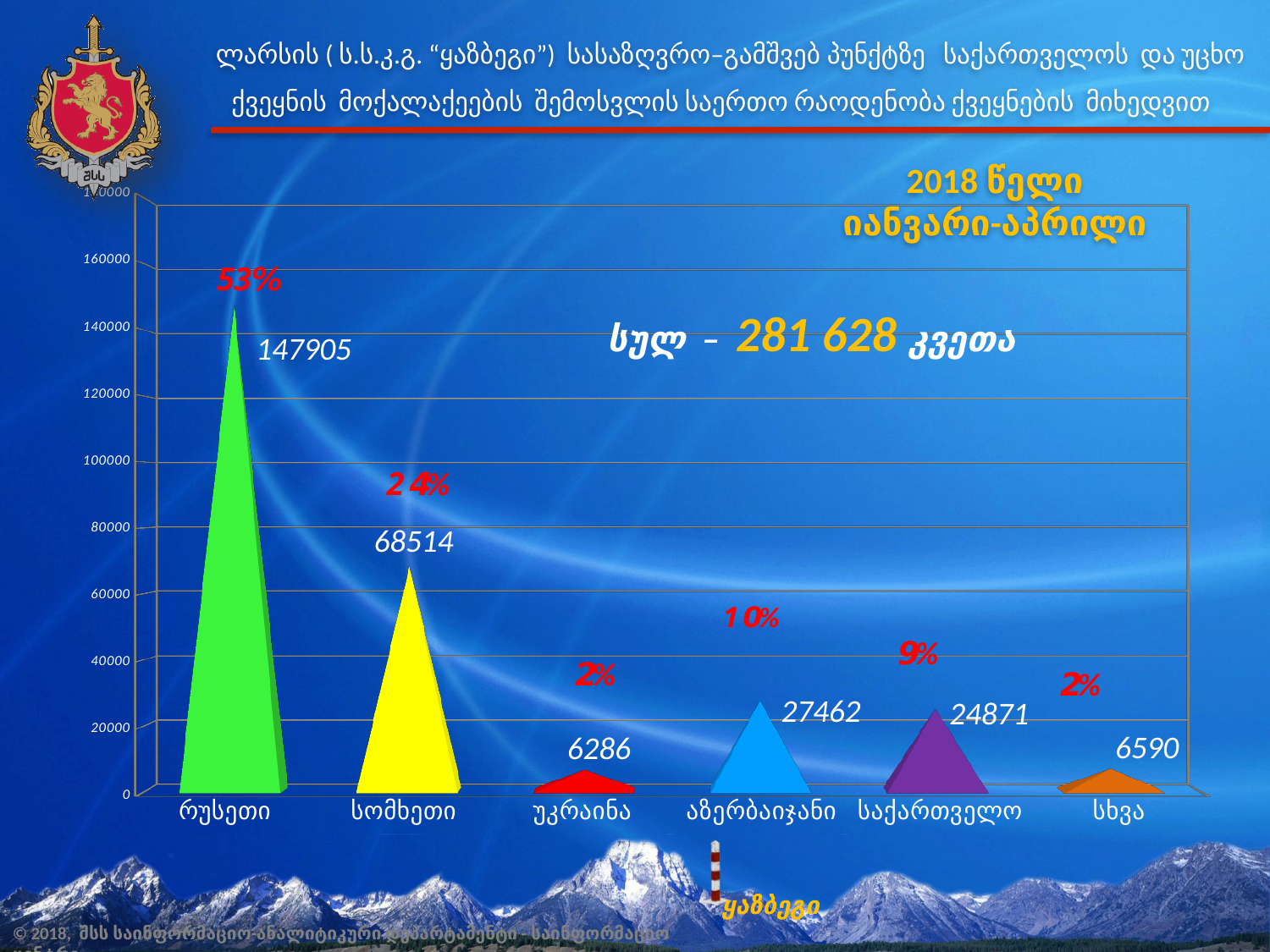
How many categories are shown on the x axis? 6 What is the value for სომხეთი? 68514 What is the value for რუსეთი? 147905 Which category has the highest value? რუსეთი What is the value for უკრაინა? 6286 What total is stated on the slide (სულ)? 281 628 Which is larger, the value for აზერბაიჯანი or the value for საქართველო? აზერბაიჯანი What is the value for აზერბაიჯანი? 27462 What percentage label is shown above the bar for სომხეთი? 24% What is the difference between the values for რუსეთი and სომხეთი? 79391 Which category has the lowest value? უკრაინა What is the value for საქართველო? 24871